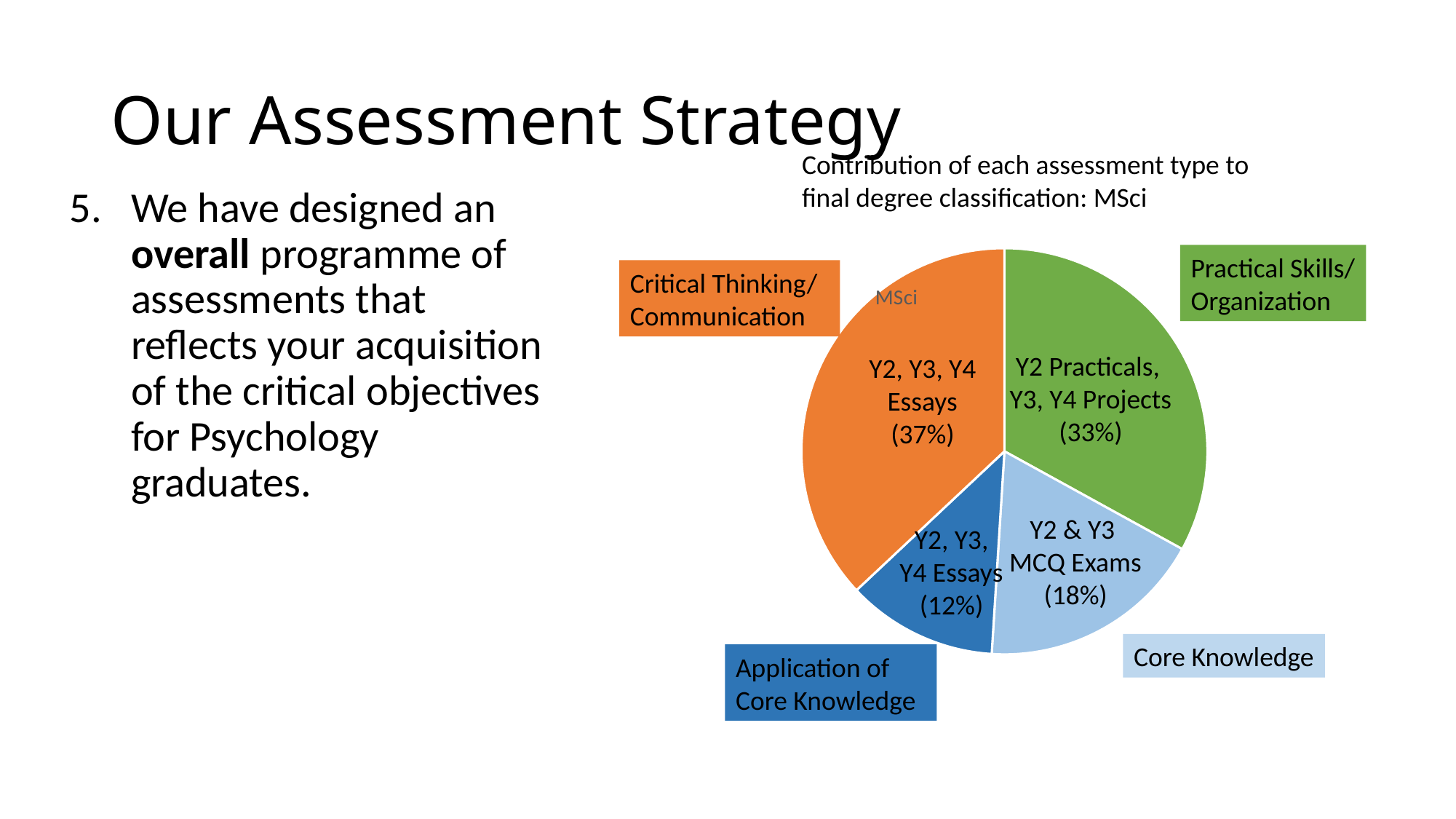
What share of the final degree classification comes from Y2 & Y3 MCQ Exams? 18% What is the title of the pie chart? Contribution of each assessment type to final degree classification: MSci What share of the final degree classification comes from Y2 Practicals, Y3, Y4 Projects? 33% Which slice of the pie chart is the largest? Y2, Y3, Y4 Essays (37%), Critical Thinking/Communication Which slice of the pie chart is the smallest? Y2, Y3, Y4 Essays (12%), Application of Core Knowledge Which is larger: the Y2 & Y3 MCQ Exams slice or the Application of Core Knowledge essays slice? Y2 & Y3 MCQ Exams What percentage is shown for the Application of Core Knowledge essays slice (Y2, Y3, Y4 Essays)? 12% What kind of chart is shown on the slide? Pie chart Which assessment category label is shown in green next to the pie chart? Practical Skills/Organization How many slices does the pie chart have? 4 What is the difference in percentage points between the Y2 Practicals, Y3, Y4 Projects slice and the Y2 & Y3 MCQ Exams slice? 15 percentage points